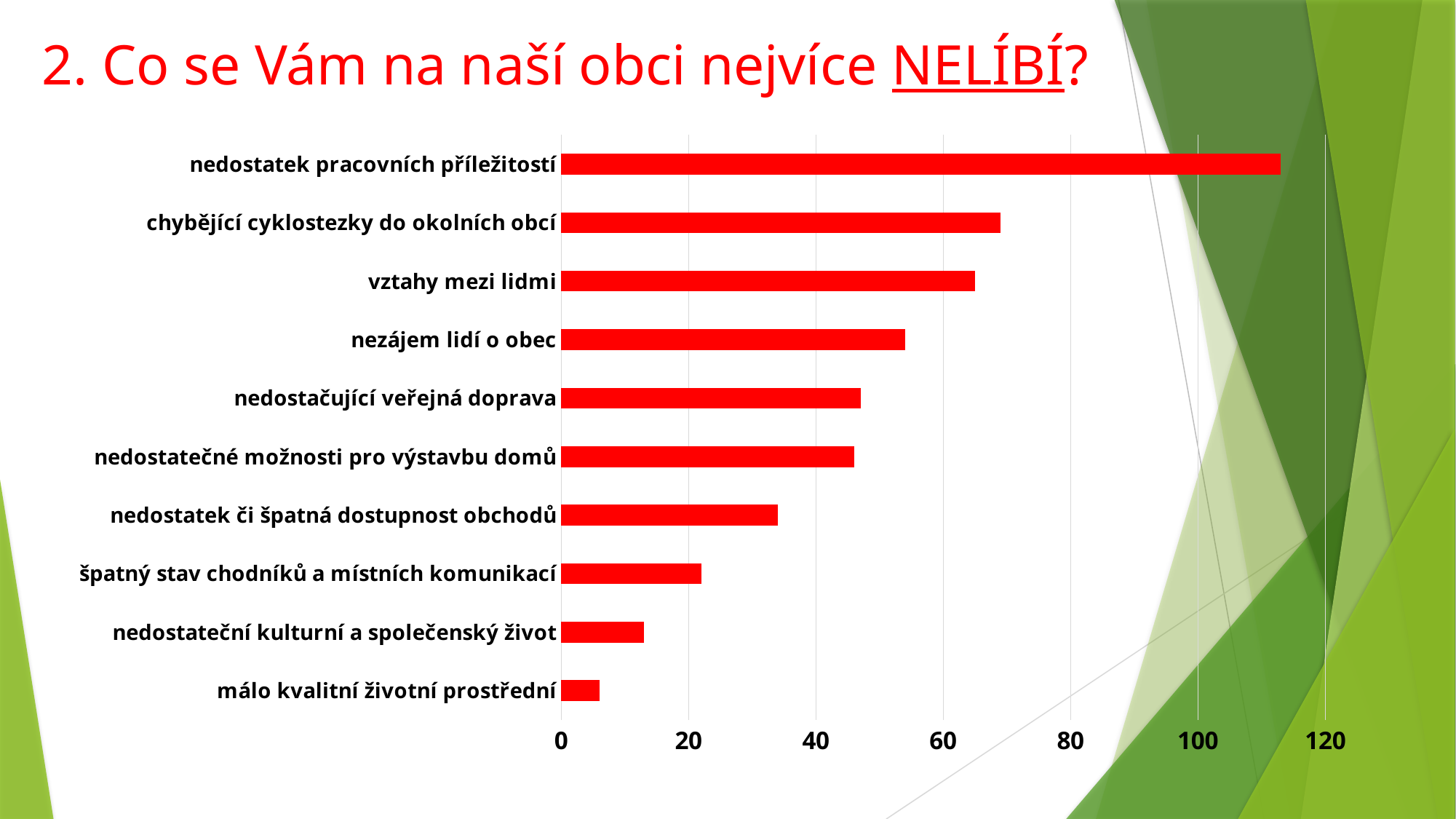
Which category has the highest value? nedostatek pracovních příležitostí Is the value for nezájem lidí o obec greater or less than 60? less Which is larger, the value for nedostateční kulturní a společenský život or the value for málo kvalitní životní prostřední? nedostateční kulturní a společenský život Is the value for nedostatek pracovních příležitostí greater or less than 100? greater Is the value for chybějící cyklostezky do okolních obcí greater or less than 60? greater What kind of chart is shown on the slide? bar chart How many categories are shown in the chart? 10 Which is larger, the value for vztahy mezi lidmi or the value for nedostačující veřejná doprava? vztahy mezi lidmi What is the title of the slide containing the chart? 2. Co se Vám na naší obci nejvíce NELÍBÍ? Which category has the lowest value? málo kvalitní životní prostřední